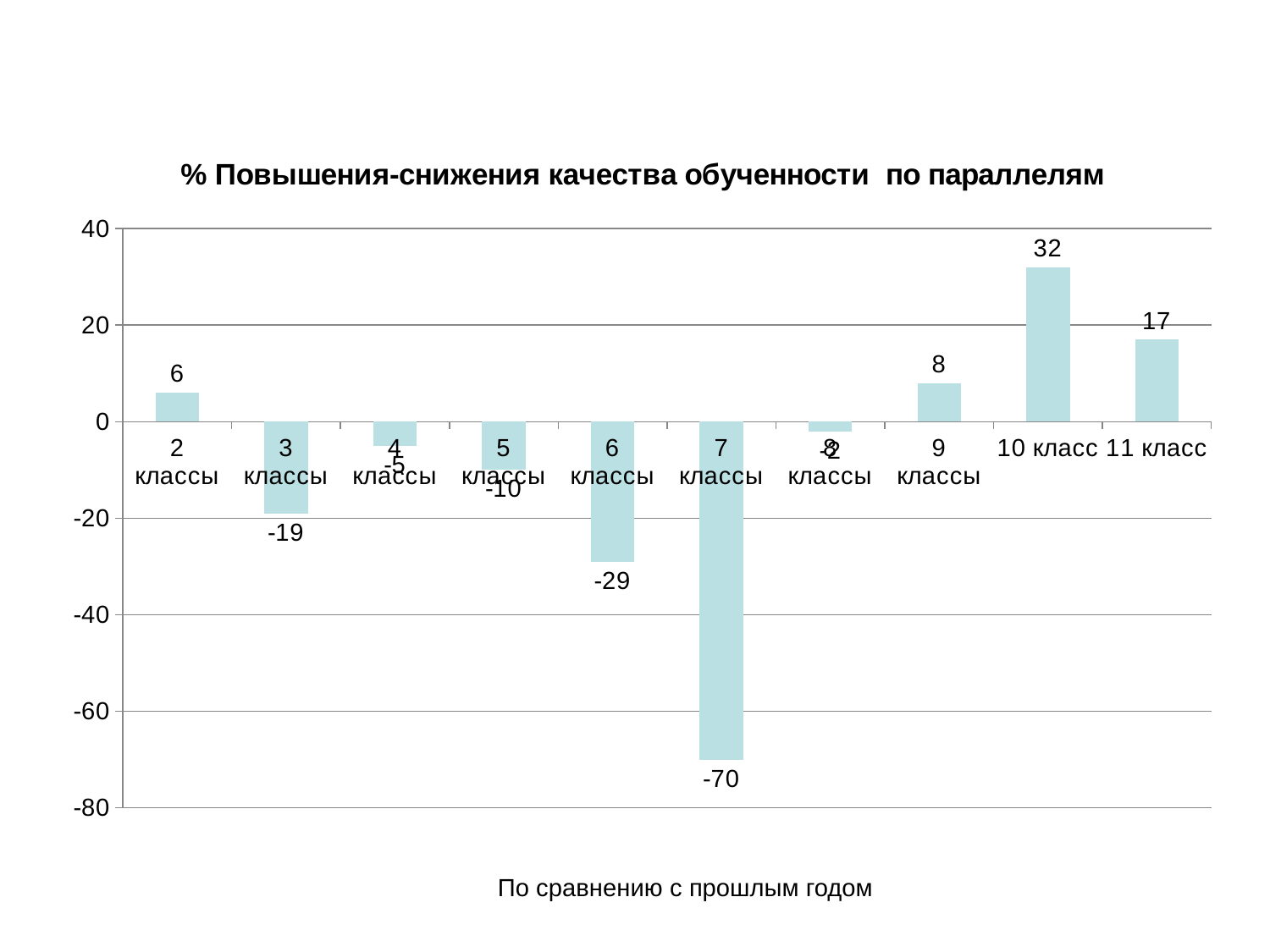
What is the difference between the values for 10 класс and 11 класс? 15 How many categories are shown on the x axis? 10 What is the value for 7 классы? -70 What is the value for 10 класс? 32 What is the value for 3 классы? -19 Which category has the highest value? 10 класс What kind of chart is shown on the slide? bar chart Which is larger, the value for 2 классы or the value for 9 классы? 9 классы Is the value for 6 классы greater or less than -20? less What is the title of the chart? % Повышения-снижения качества обученности по параллелям What is the value for 11 класс? 17 Which category has the lowest value? 7 классы